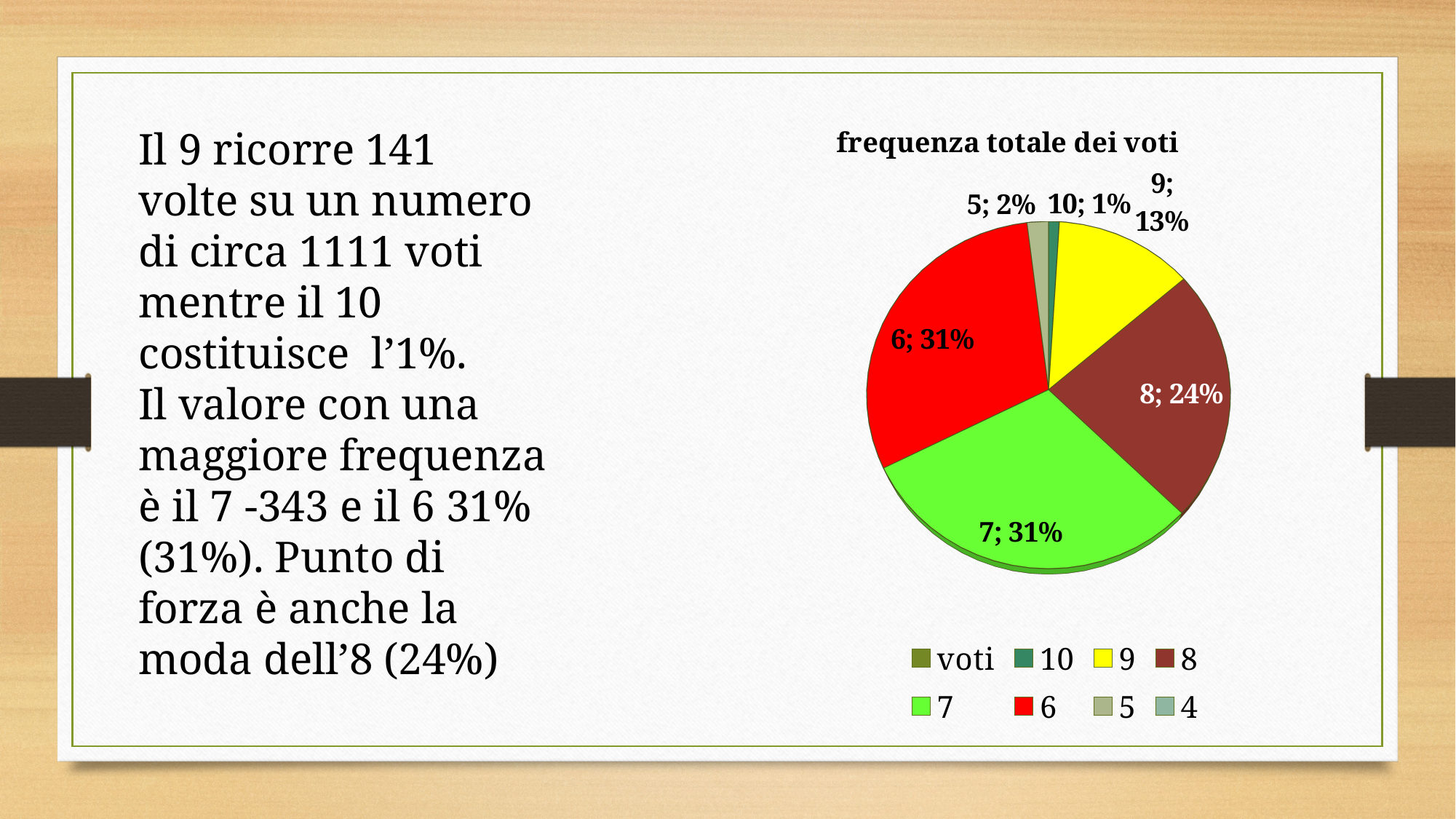
How many entries does the legend list? 8 Which labelled slice has the smallest share of the pie? 10 What share of the pie does the slice for 5 represent? 2% What kind of chart is shown on the slide? pie chart What share of the pie does the slice for 8 represent? 24% What colour is the slice for 6? red What is the title of the chart? frequenza totale dei voti What is the difference in percentage points between the slice for 8 and the slice for 9? 11 What share of the pie does the slice for 6 represent? 31% Which slice is larger, the one for 8 or the one for 9? 8